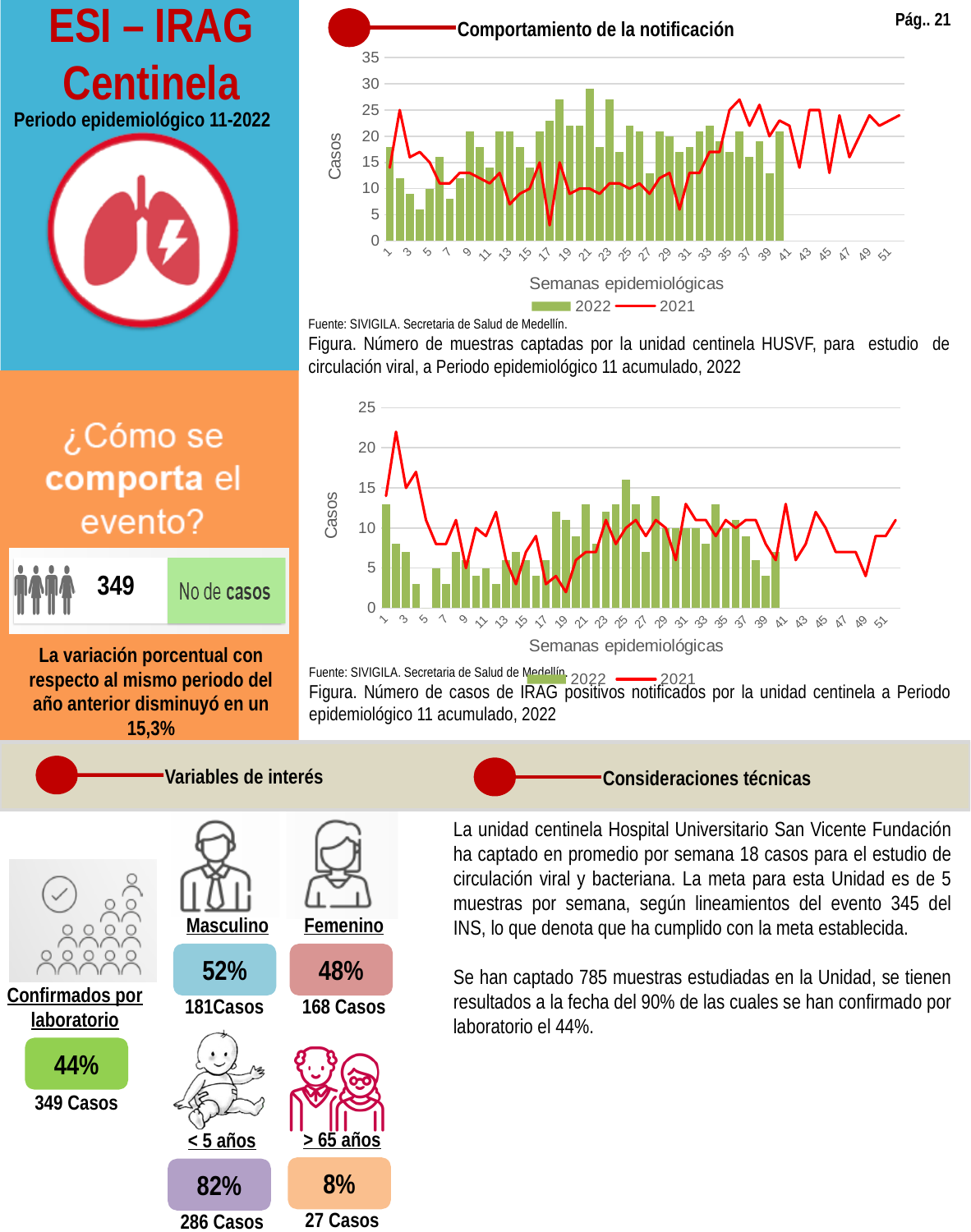
In the top chart 'Comportamiento de la notificación', what kind of chart is used to show the 2022 data? bar chart In the top chart 'Comportamiento de la notificación', how many series does the legend list? 2 In the bottom chart (IRAG positivos), does the 2021 line rise or fall between week 2 and week 6? fall In the bottom chart (IRAG positivos), is the 2022 value for week 25 greater or less than 10? greater In the bottom chart (IRAG positivos), what is the label of the x axis? Semanas epidemiológicas In the bottom chart (IRAG positivos), which 2022 bar is taller, week 25 or week 3? week 25 In the bottom chart (IRAG positivos), is the 2022 value for week 3 greater or less than 5? greater In the top chart 'Comportamiento de la notificación', what is the highest value shown on the y axis? 35 In the top chart 'Comportamiento de la notificación', which 2022 bar is taller, week 21 or week 5? week 21 In the top chart 'Comportamiento de la notificación', what is the label of the y axis? Casos In the top chart 'Comportamiento de la notificación', is the 2022 value for week 21 greater or less than 25? greater